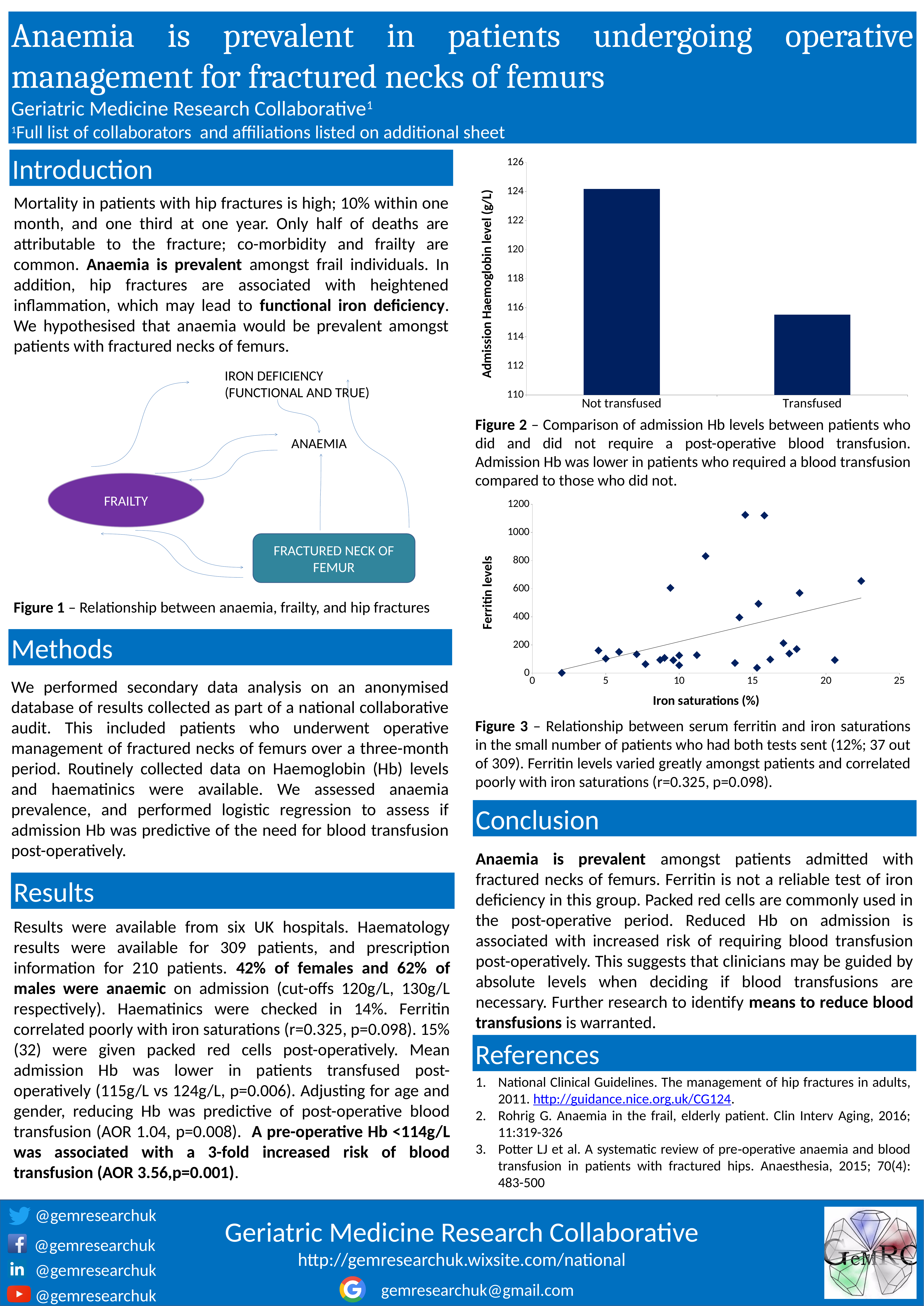
What kind of chart is Figure 2 (the chart comparing Not transfused and Transfused patients)? bar chart In Figure 3, does the fitted trend line rise or fall as iron saturations increase? rise In Figure 2, is the admission haemoglobin level for Transfused greater or less than 114? greater What kind of chart is Figure 3 (the chart of ferritin levels against iron saturations)? scatter chart In Figure 2, how many categories are shown on the x axis? 2 In Figure 3, is the ferritin level of the point with the highest iron saturation (around 22.5%) greater or less than 400? greater In Figure 2, which category has the lower admission haemoglobin level? Transfused In Figure 2, is the admission haemoglobin level for Not transfused greater or less than 120? greater In Figure 3, what is the x-axis label? Iron saturations (%) What is the y-axis label of Figure 2? Admission Haemoglobin level (g/L) In Figure 2, which category has the higher admission haemoglobin level? Not transfused